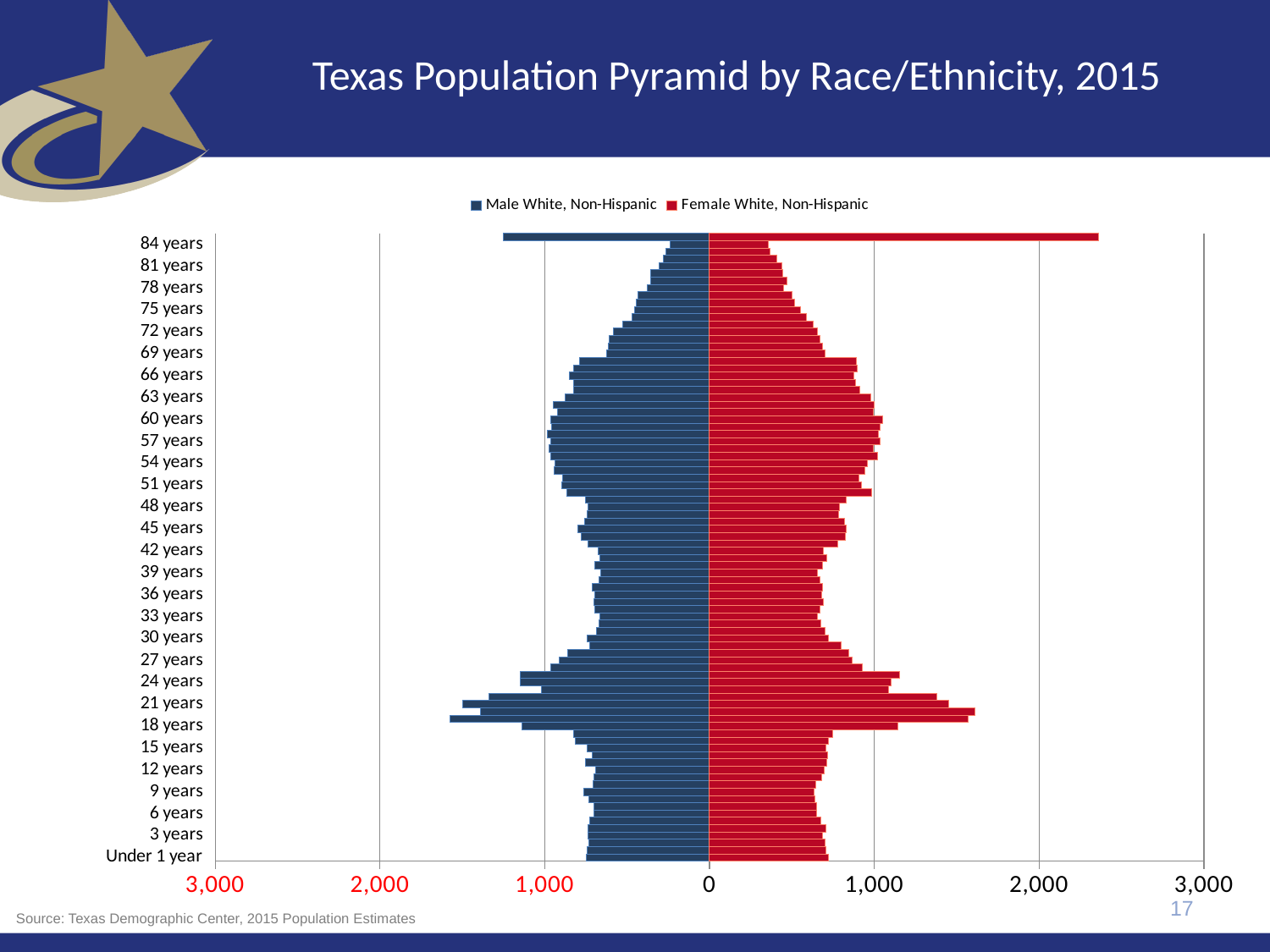
How many series does the legend list? 2 Which colour represents the Female White, Non-Hispanic series? Red For the Male White, Non-Hispanic series, which is larger: the value for 18 years or the value for 36 years? 18 years Which is larger at 84 years: the Male White, Non-Hispanic value or the Female White, Non-Hispanic value? Female White, Non-Hispanic What is the title of the chart? Texas Population Pyramid by Race/Ethnicity, 2015 What kind of chart is shown on the slide? Bar chart Is the Female White, Non-Hispanic value for Under 1 year greater or less than 1,000? less Is the Male White, Non-Hispanic value for 18 years greater or less than 1,000? greater